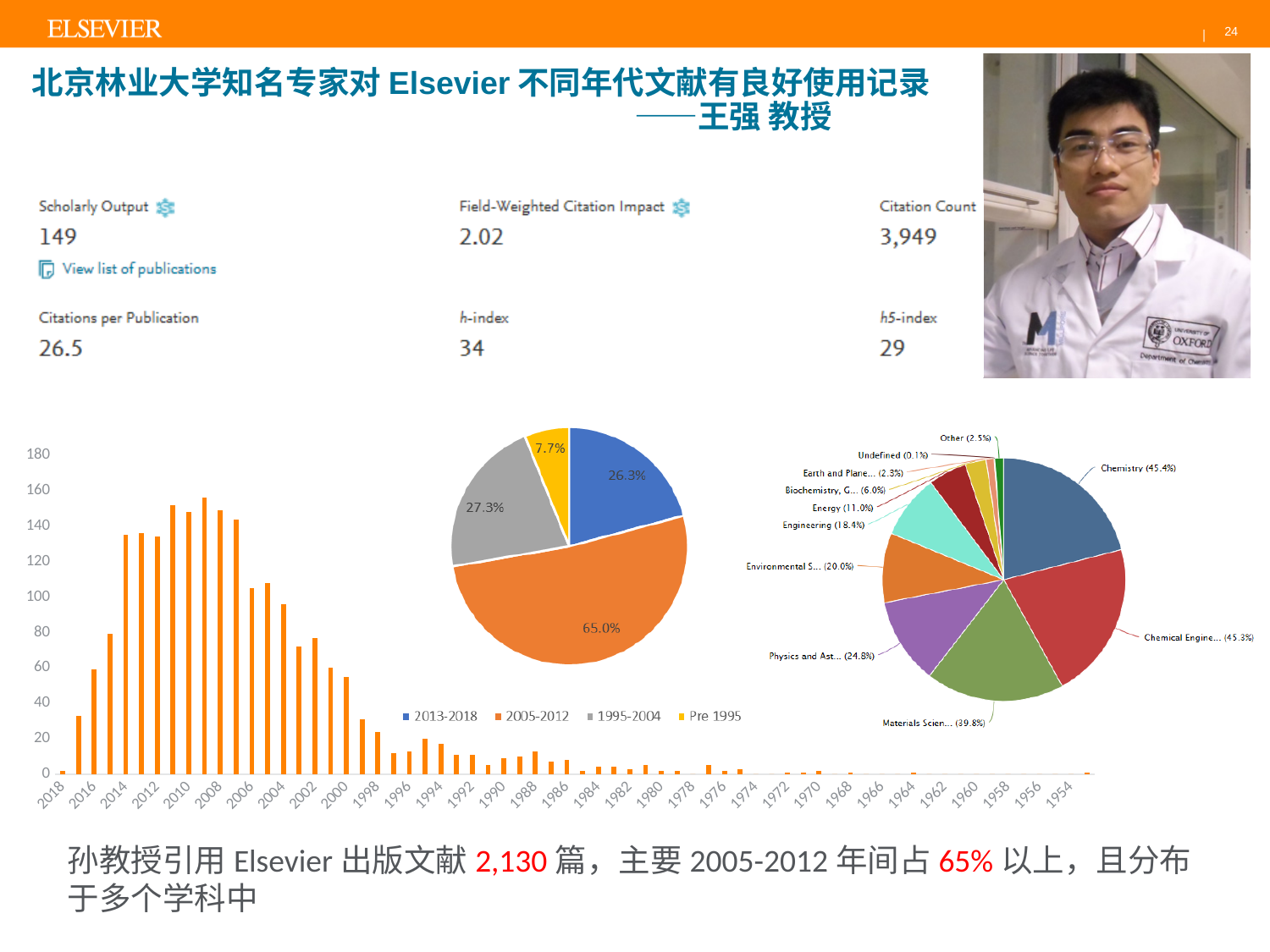
In the middle pie chart, what percentage is shown for the 2005-2012 slice? 65.0% How many entries does the legend of the middle pie chart list? 4 In the right pie chart, what percentage is shown for Energy? 11.0% In the left bar chart, is the value for 2008 greater or less than 140? greater In the right pie chart, what percentage is shown for Engineering? 18.4% In the middle pie chart, which period has the largest slice? 2005-2012 What kind of chart is the chart on the left showing values by year? Bar chart In the middle pie chart, what percentage is shown for the Pre 1995 slice? 7.7% In the left bar chart, is the value for 1998 greater or less than 40? less In the right pie chart, which category has the smallest share? Undefined (0.1%) In the middle pie chart, which period has the smallest slice? Pre 1995 In the right pie chart, how many labelled categories are there? 11